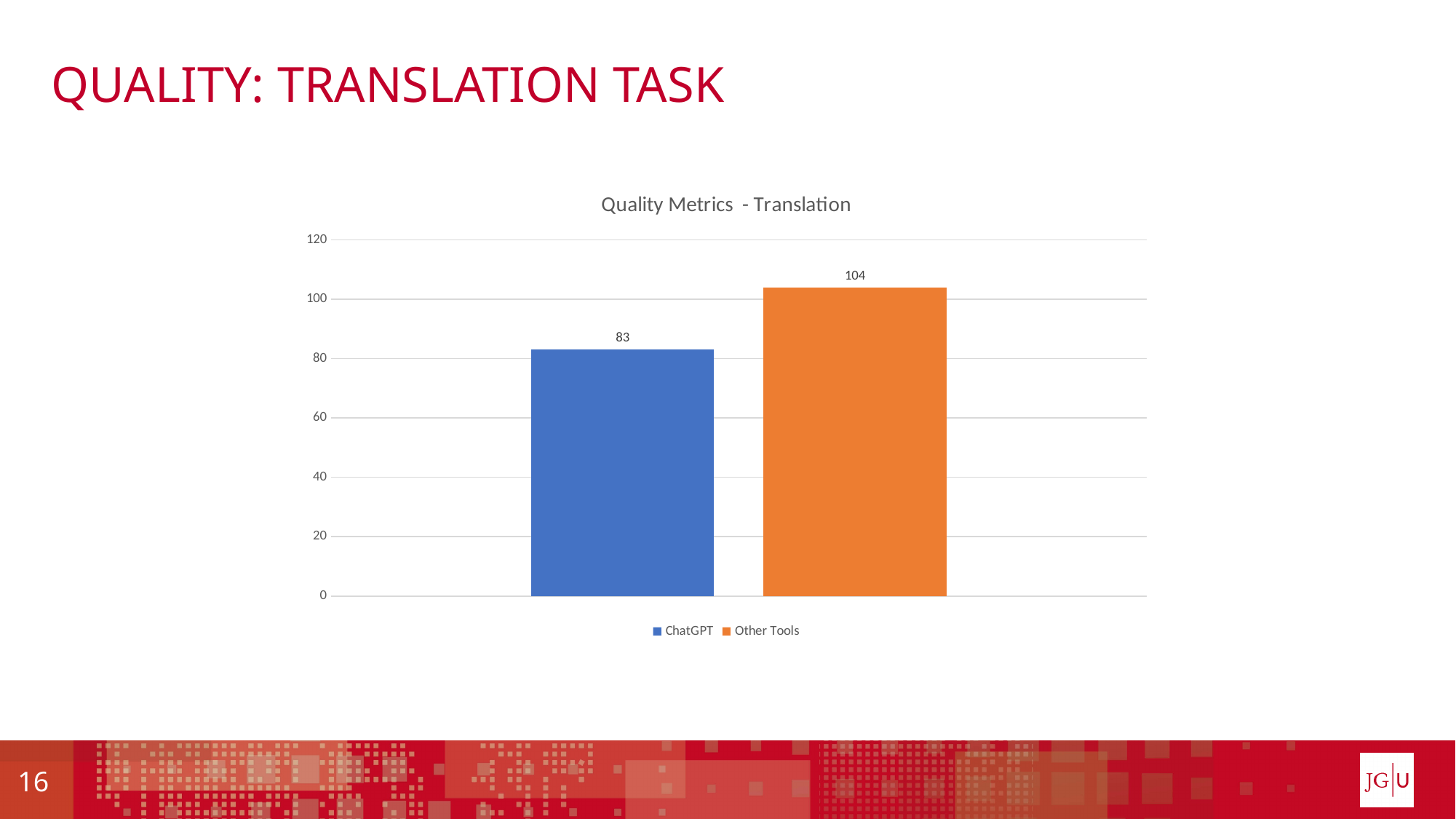
Which series has the highest value? Other Tools Is the value for ChatGPT greater or less than 100? less What is the value for ChatGPT? 83 What kind of chart is shown on the slide? bar chart Which is larger, the value for ChatGPT or the value for Other Tools? Other Tools What is the difference between the values for Other Tools and ChatGPT? 21 What is the value for Other Tools? 104 What is the title of the chart? Quality Metrics - Translation What colour is the bar for Other Tools? orange Which series has the lowest value? ChatGPT Is the value for Other Tools greater or less than 100? greater How many series does the legend list? 2